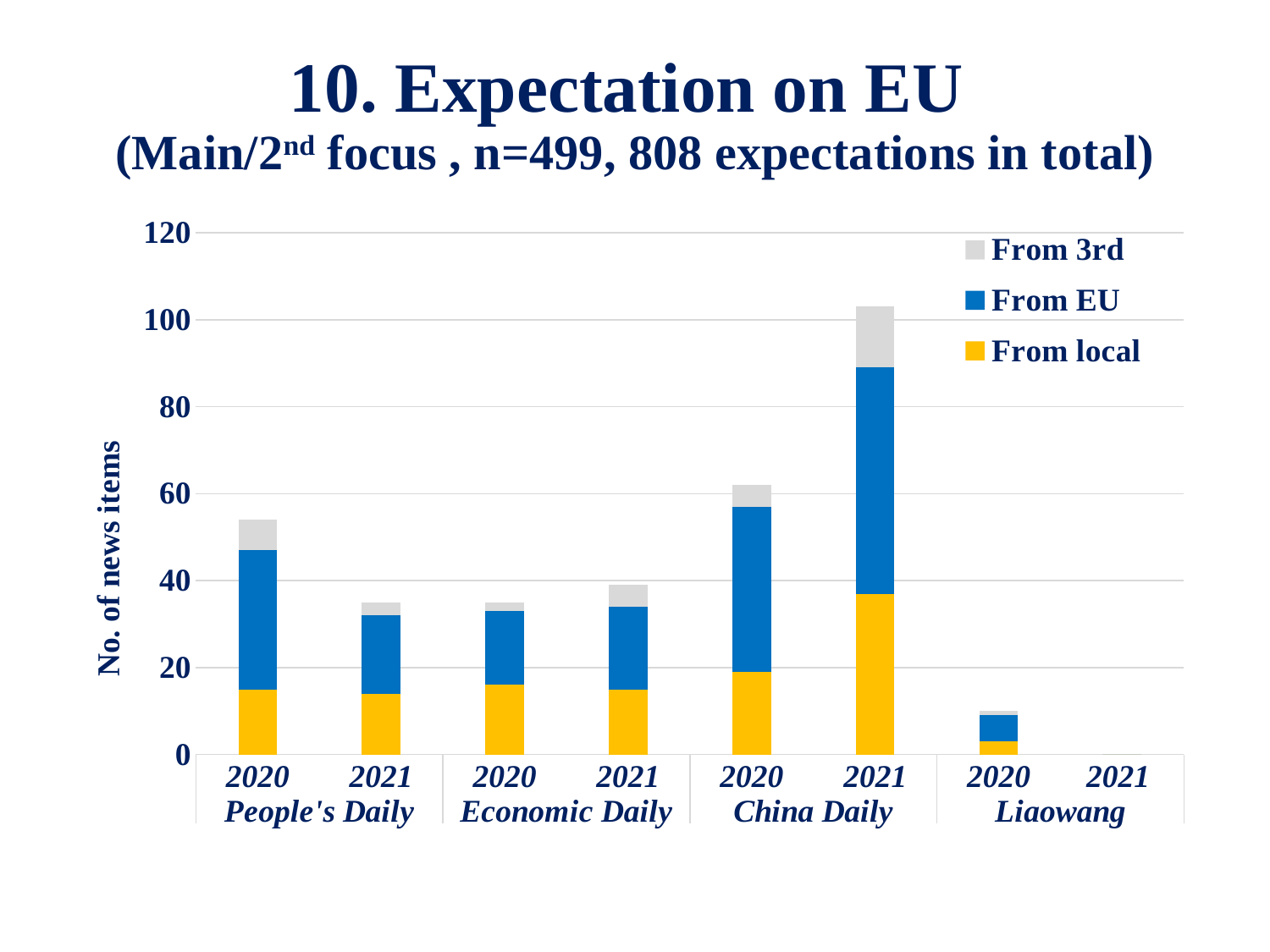
What is the label on the y axis? No. of news items Is the total for People's Daily 2020 greater or less than 60? less What kind of chart is shown on the slide? stacked bar chart Which is larger, the total for People's Daily 2020 or People's Daily 2021? People's Daily 2020 Is the total for China Daily 2021 greater or less than 100? greater How many series does the legend list? 3 How many newspaper-year categories are shown on the x axis? 8 Is the total for China Daily 2020 greater or less than 60? greater For China Daily, does the total rise or fall from 2020 to 2021? rise Which newspaper-year has the tallest stacked bar? China Daily 2021 Which newspaper-year has the lowest total, with no visible bar at all? Liaowang 2021